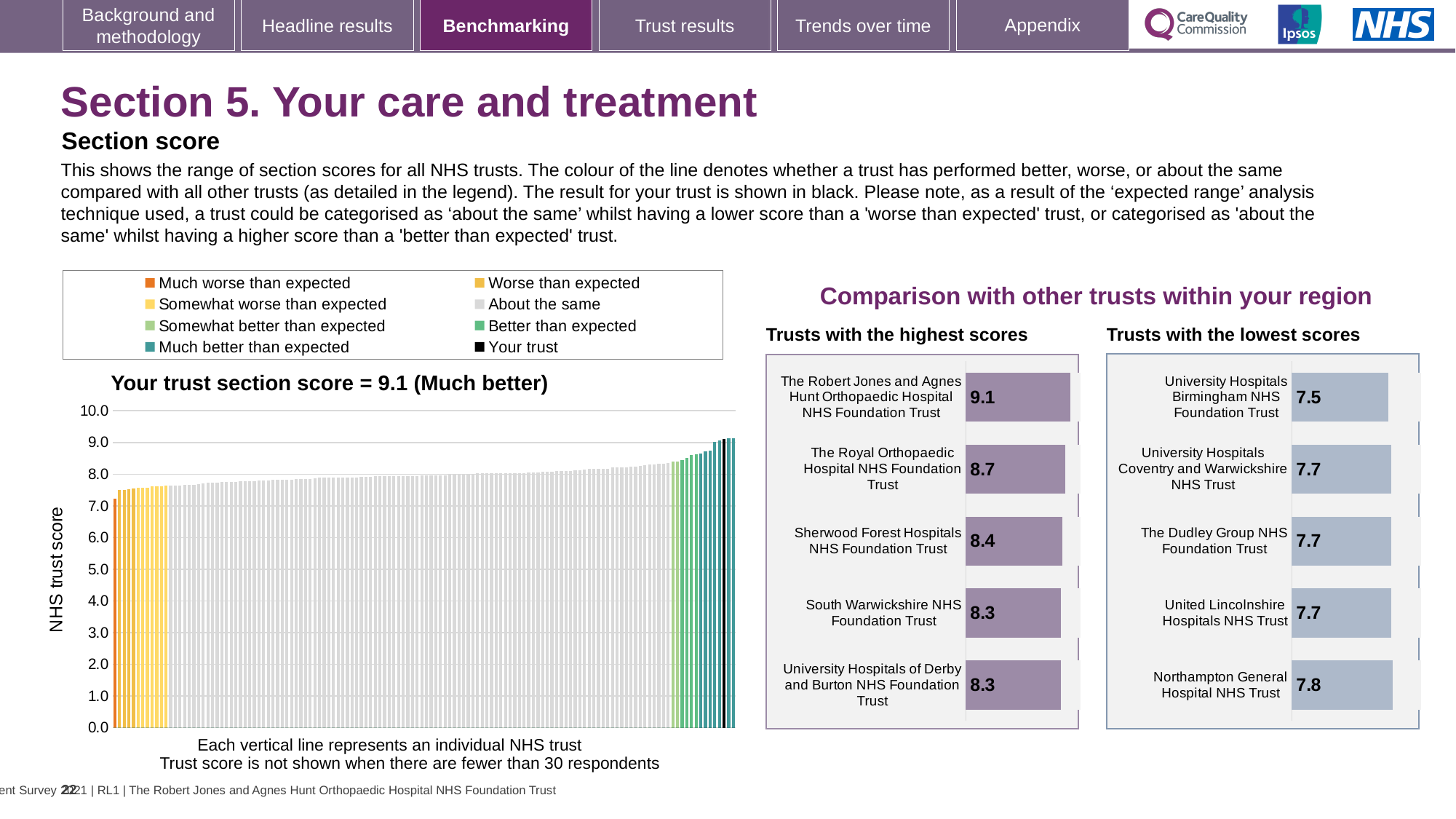
On the 'Trusts with the highest scores' chart, what is the difference between the scores of The Robert Jones and Agnes Hunt Orthopaedic Hospital NHS Foundation Trust and The Royal Orthopaedic Hospital NHS Foundation Trust? 0.4 How many entries does the legend above the 'Your trust section score' chart list? 8 How many trusts are shown on the 'Trusts with the highest scores' chart? 5 What is the y-axis label on the 'Your trust section score' chart? NHS trust score On the 'Trusts with the lowest scores' chart, what is the difference between the scores of Northampton General Hospital NHS Trust and University Hospitals Birmingham NHS Foundation Trust? 0.3 On the 'Trusts with the lowest scores' chart, what is the score for Northampton General Hospital NHS Trust? 7.8 What kind of chart is the 'Your trust section score' chart? bar chart On the 'Your trust section score' chart, do the bars rise or fall from left to right? rise On the 'Your trust section score' chart, what is the section score for your trust? 9.1 On the 'Trusts with the highest scores' chart, what is the score for Sherwood Forest Hospitals NHS Foundation Trust? 8.4 On the 'Trusts with the highest scores' chart, which trust has the highest score? The Robert Jones and Agnes Hunt Orthopaedic Hospital NHS Foundation Trust On the 'Trusts with the lowest scores' chart, which trust has the lowest score? University Hospitals Birmingham NHS Foundation Trust